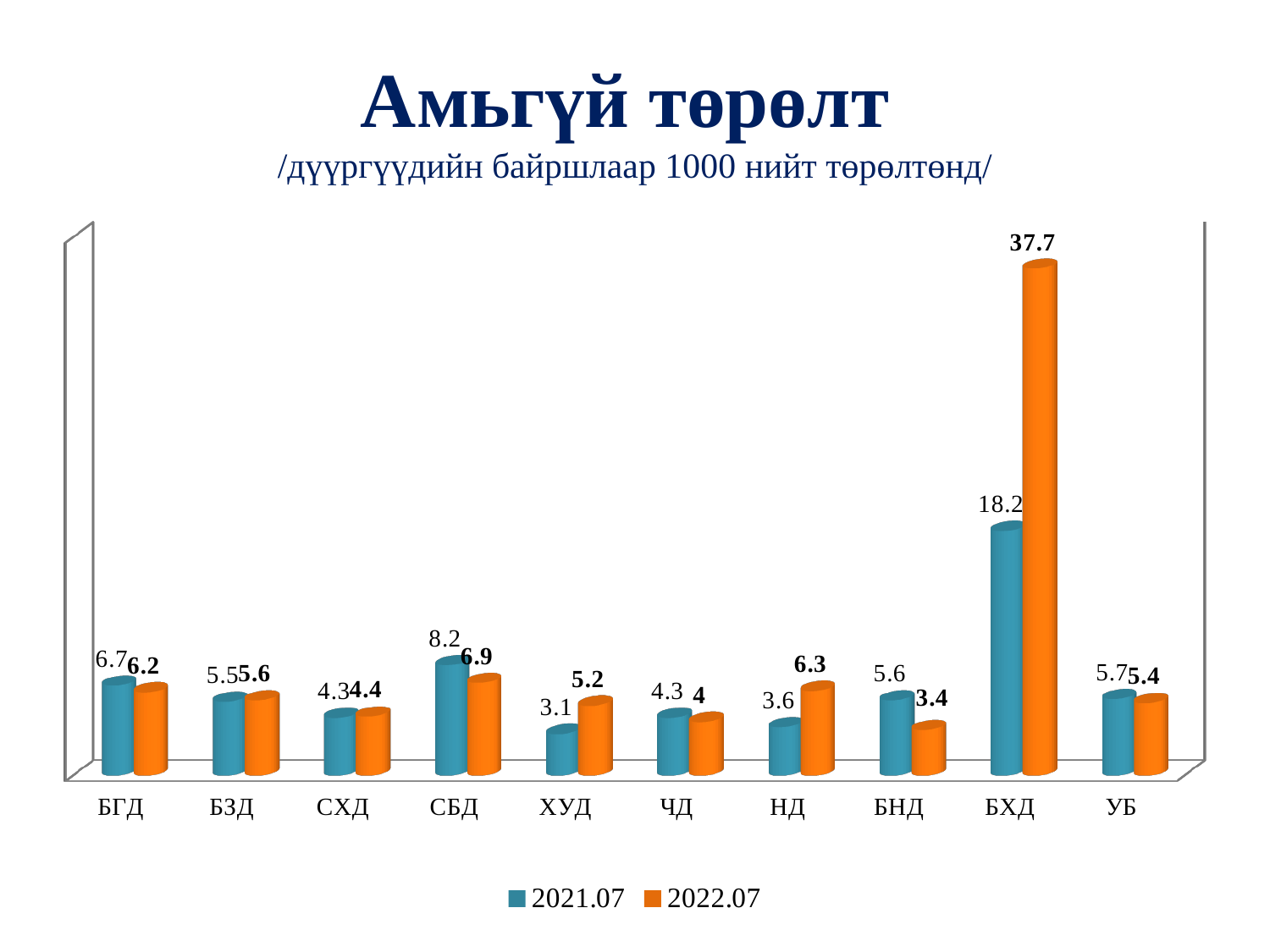
How many districts are shown on the x axis? 10 Which district has the highest value in the 2022.07 series? БХД Which district has the lowest value in the 2021.07 series? ХУД What kind of chart is shown on the slide? Bar chart What is the difference between the 2022.07 and 2021.07 values for БХД? 19.5 For БНД, which series has the larger value, 2021.07 or 2022.07? 2021.07 What is the value for НД in the 2022.07 series? 6.3 What is the title of the chart? Амьгүй төрөлт What is the value for СБД in the 2021.07 series? 8.2 How many series does the legend list? 2 What is the value for ХУД in the 2021.07 series? 3.1 What is the value for БХД in the 2022.07 series? 37.7